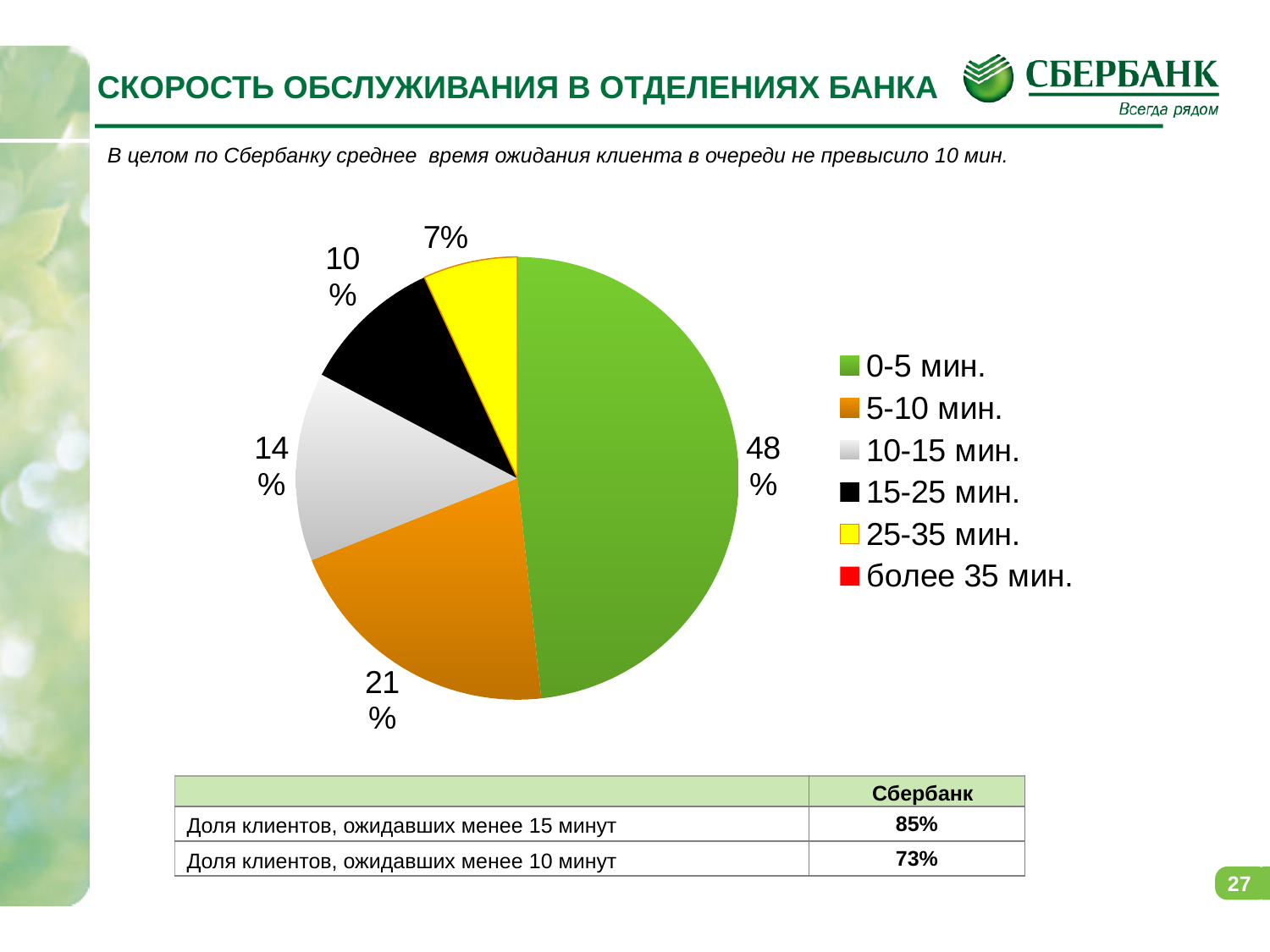
What is the difference in percentage points between the "0-5 мин." slice and the "5-10 мин." slice? 27 What share of the pie does the "0-5 мин." slice represent? 48% How many categories does the legend list? 6 Which slice is larger: "10-15 мин." or "15-25 мин."? 10-15 мин. Which category has the largest slice of the pie? 0-5 мин. What kind of chart is shown on the slide? pie chart What is the value shown for the "10-15 мин." slice? 14% What is the value shown for the "5-10 мин." slice? 21% What is the value shown for the "25-35 мин." slice? 7% Which of the labeled slices is the smallest? 25-35 мин. What is the value shown for the "15-25 мин." slice? 10% What colour is the "15-25 мин." slice? black